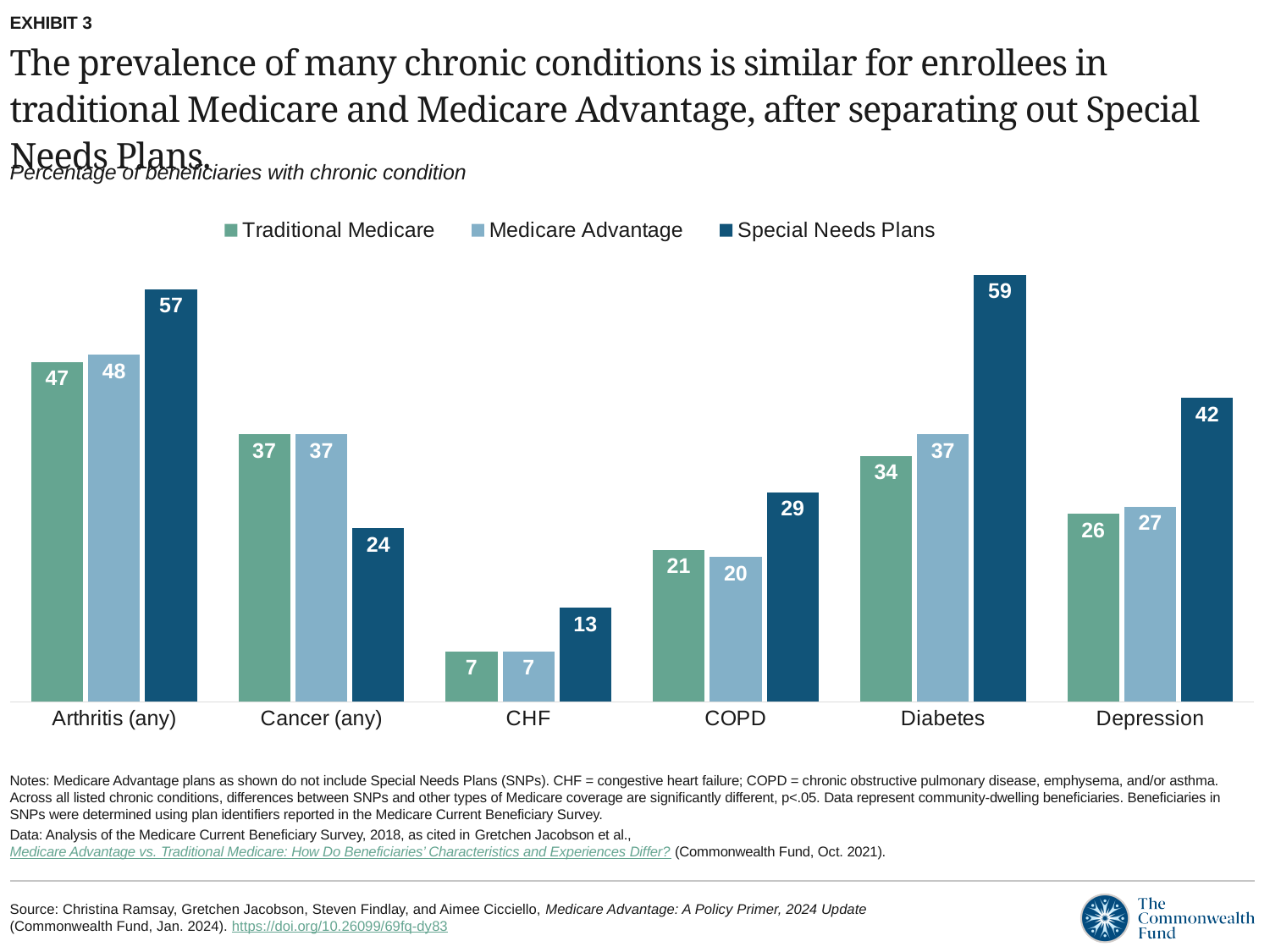
What percentage of Special Needs Plans beneficiaries have diabetes? 59 What is the difference between the Special Needs Plans and Medicare Advantage values for Cancer (any)? 13 What type of chart is shown on the slide? Bar chart How many series does the legend list? 3 How many chronic conditions are shown on the x axis? 6 For Arthritis (any), which is larger: the Traditional Medicare value or the Special Needs Plans value? Special Needs Plans Which series is shown in the darkest blue colour? Special Needs Plans Which chronic condition has the highest value for Special Needs Plans? Diabetes Which chronic condition has the lowest value for Traditional Medicare? CHF What is the value for Medicare Advantage for COPD? 20 What is the difference between the Special Needs Plans and Traditional Medicare values for Diabetes? 25 What is the value for Traditional Medicare for Depression? 26